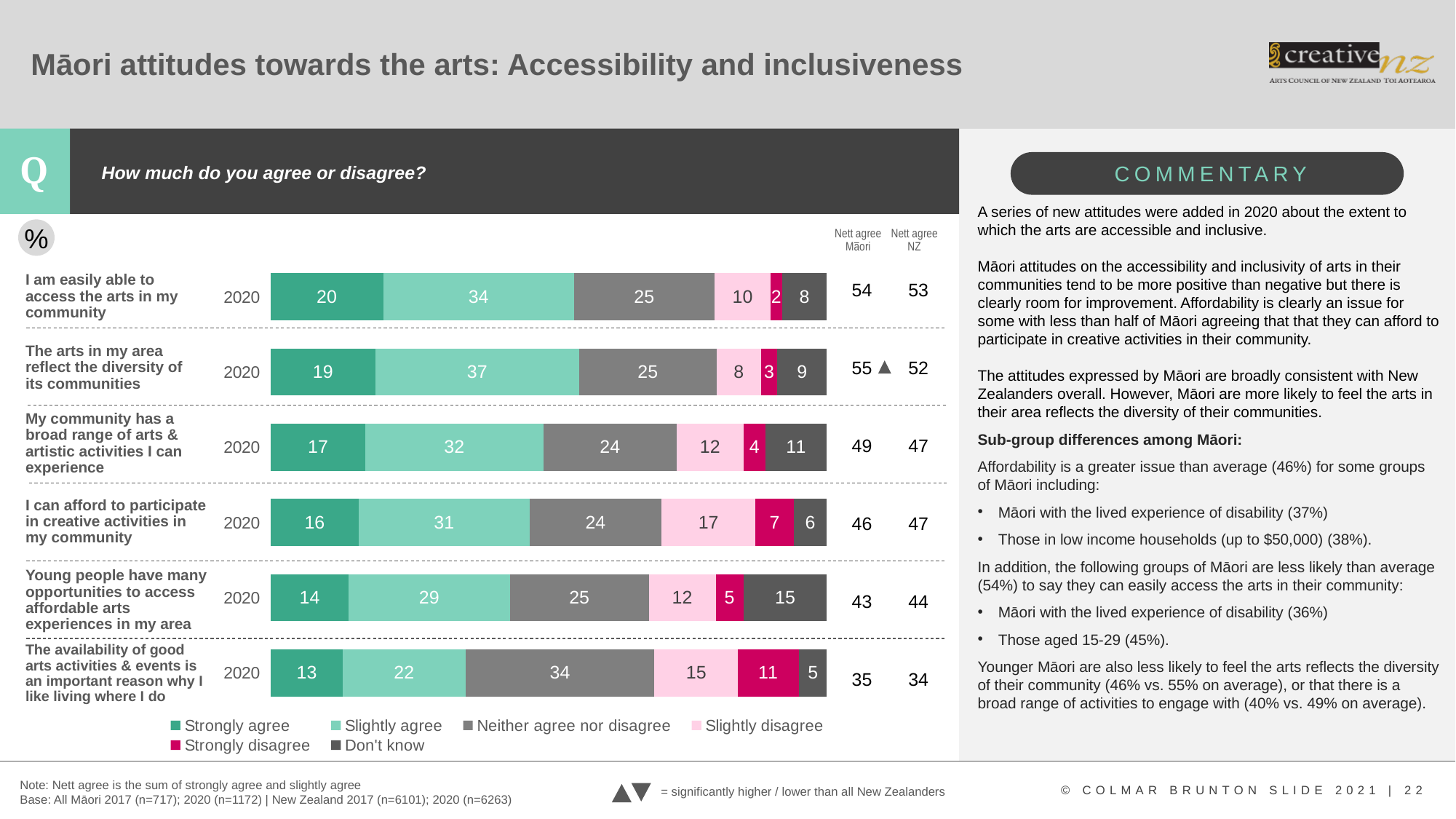
Which statement has the highest 'Strongly disagree' value? The availability of good arts activities & events is an important reason why I like living where I do How many statements are shown in the chart? 6 What is the difference between the 'Slightly agree' values for 'The arts in my area reflect the diversity of its communities' and 'Young people have many opportunities to access affordable arts experiences in my area'? 8 What is the 'Strongly agree' value for 'I am easily able to access the arts in my community'? 20 What is the 'Nett agree NZ' value for 'I can afford to participate in creative activities in my community'? 47 Which has the larger 'Don't know' value: 'Young people have many opportunities to access affordable arts experiences in my area' or 'I can afford to participate in creative activities in my community'? Young people have many opportunities to access affordable arts experiences in my area What is the total of the stacked bar for 'My community has a broad range of arts & artistic activities I can experience'? 100 What kind of chart is shown on the slide? Stacked bar chart How many series does the legend list? 6 Which statement has the lowest 'Strongly agree' value? The availability of good arts activities & events is an important reason why I like living where I do Which year is shown for all the bars in the chart? 2020 What is the 'Neither agree nor disagree' value for 'The availability of good arts activities & events is an important reason why I like living where I do'? 34